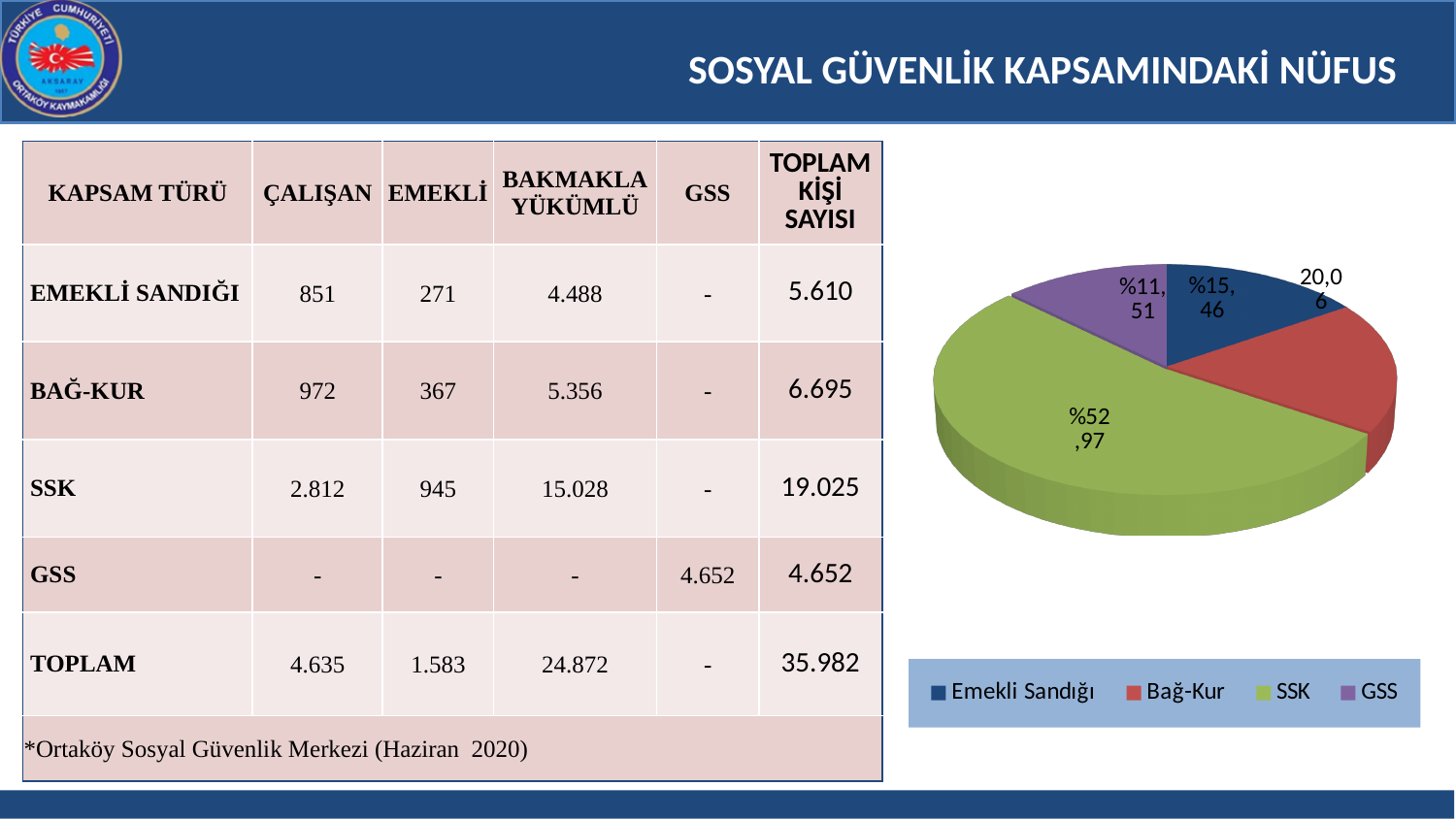
Which category has the largest slice in the pie chart? SSK Which categories are listed in the pie chart's legend? Emekli Sandığı, Bağ-Kur, SSK, GSS What kind of chart is shown on the right side of the slide? pie chart What colour is the SSK slice in the pie chart? green How many slices does the pie chart have? 4 In the pie chart, which slice is larger: Emekli Sandığı or GSS? Emekli Sandığı In the pie chart, which slice is larger: SSK or Bağ-Kur? SSK Which category has the smallest slice in the pie chart? GSS What percentage does the pie chart show for Emekli Sandığı? %15,46 What percentage does the pie chart show for GSS? %11,51 How many entries does the pie chart's legend list? 4 What percentage does the pie chart show for SSK? %52,97